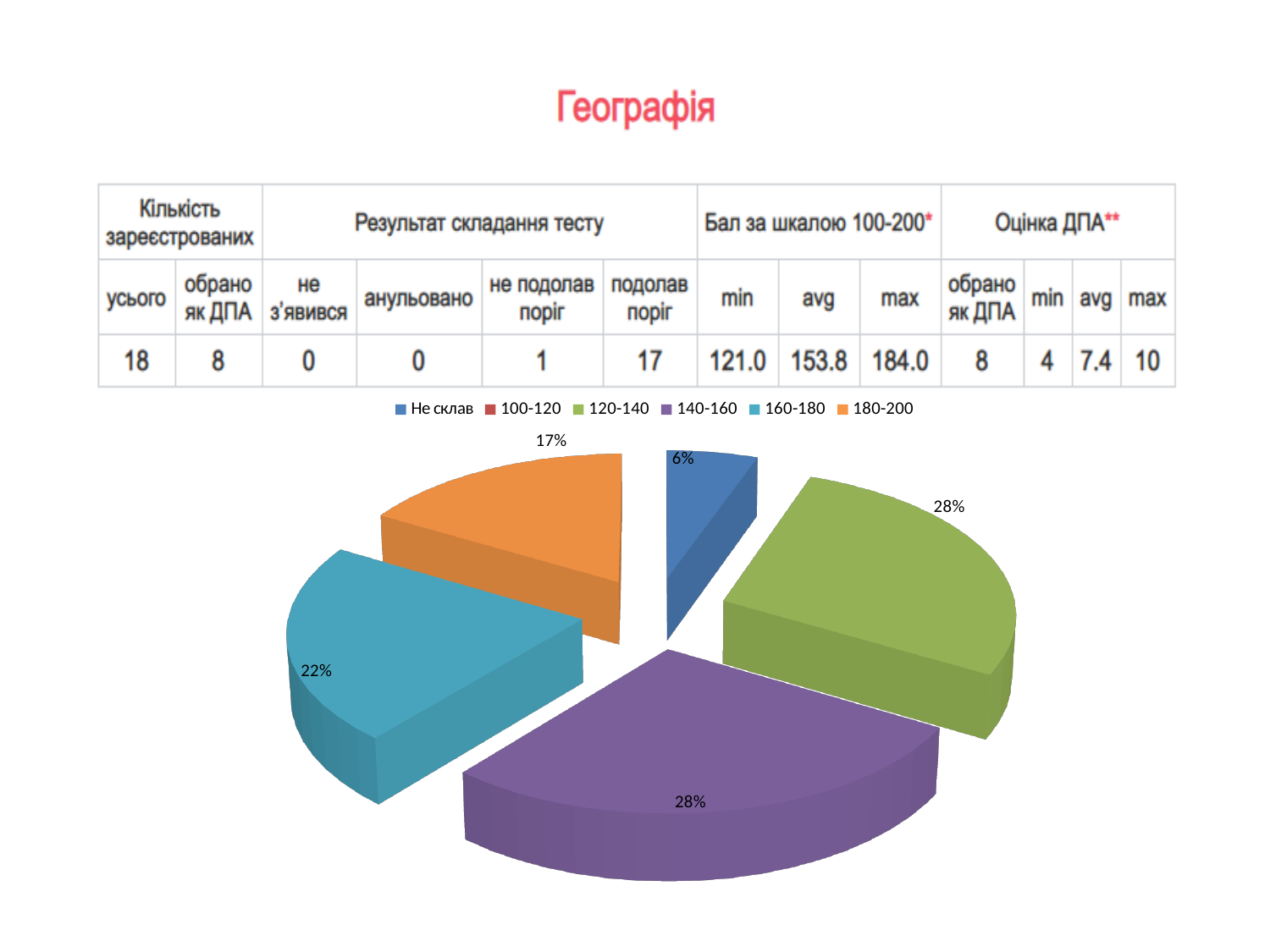
Which labelled slice of the pie is the smallest? Не склав What percentage does the '180-200' slice show? 17% What is the difference in percentage points between the '120-140' slice and the '180-200' slice? 11% What percentage does the '140-160' slice show? 28% Which slice is larger, '160-180' or '180-200'? 160-180 What percentage does the 'Не склав' slice show? 6% What kind of chart is shown on the slide? pie chart What percentage does the '120-140' slice show? 28% How many slices are visible in the pie chart? 5 How many entries does the legend of the pie chart list? 6 What percentage does the '160-180' slice show? 22% What colour is the '140-160' slice in the pie chart? purple